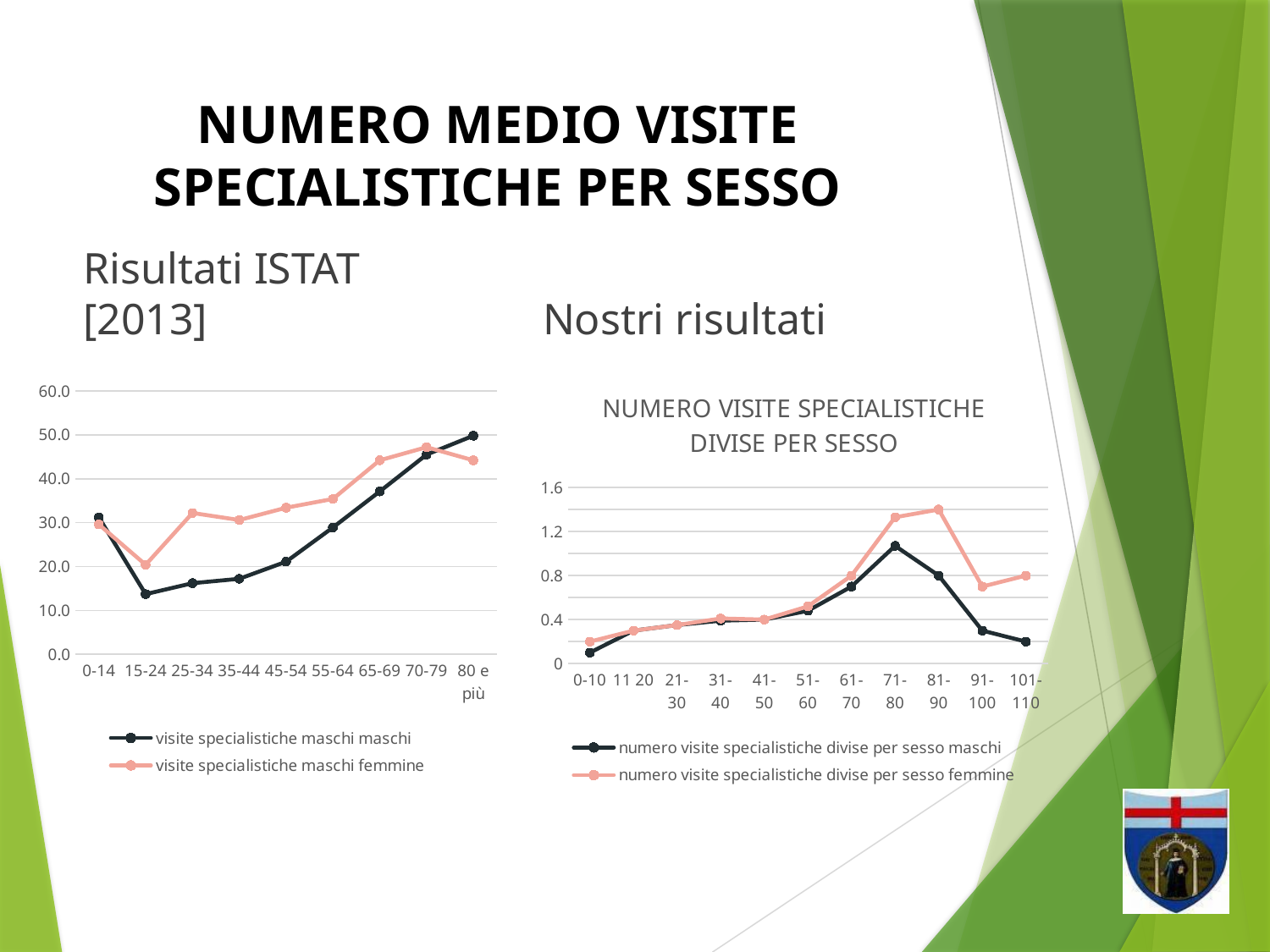
In the right chart 'NUMERO VISITE SPECIALISTICHE DIVISE PER SESSO', at age 91-100, which series has the larger value: maschi or femmine? femmine In the right chart 'NUMERO VISITE SPECIALISTICHE DIVISE PER SESSO', is the value for the femmine series at 81-90 greater or less than 1.2? greater How many age categories are shown on the x axis of the right chart 'NUMERO VISITE SPECIALISTICHE DIVISE PER SESSO'? 11 In the left chart (Risultati ISTAT [2013]), at age 35-44, which series has the larger value: maschi or femmine? femmine In the right chart 'NUMERO VISITE SPECIALISTICHE DIVISE PER SESSO', does the maschi series rise or fall from 71-80 to 101-110? fall How many age categories are shown on the x axis of the left chart (Risultati ISTAT [2013])? 9 How many series does the legend of the right chart 'NUMERO VISITE SPECIALISTICHE DIVISE PER SESSO' list? 2 In the left chart (Risultati ISTAT [2013]), which age category has the lowest value for 'visite specialistiche maschi maschi'? 15-24 In the right chart 'NUMERO VISITE SPECIALISTICHE DIVISE PER SESSO', which age category has the highest value for the maschi series? 71-80 In the left chart (Risultati ISTAT [2013]), which age category has the highest value for 'visite specialistiche maschi maschi'? 80 e più What kind of chart is the left chart under 'Risultati ISTAT [2013]'? line chart In the left chart (Risultati ISTAT [2013]), is the value for 'visite specialistiche maschi maschi' at '80 e più' greater or less than 40.0? greater